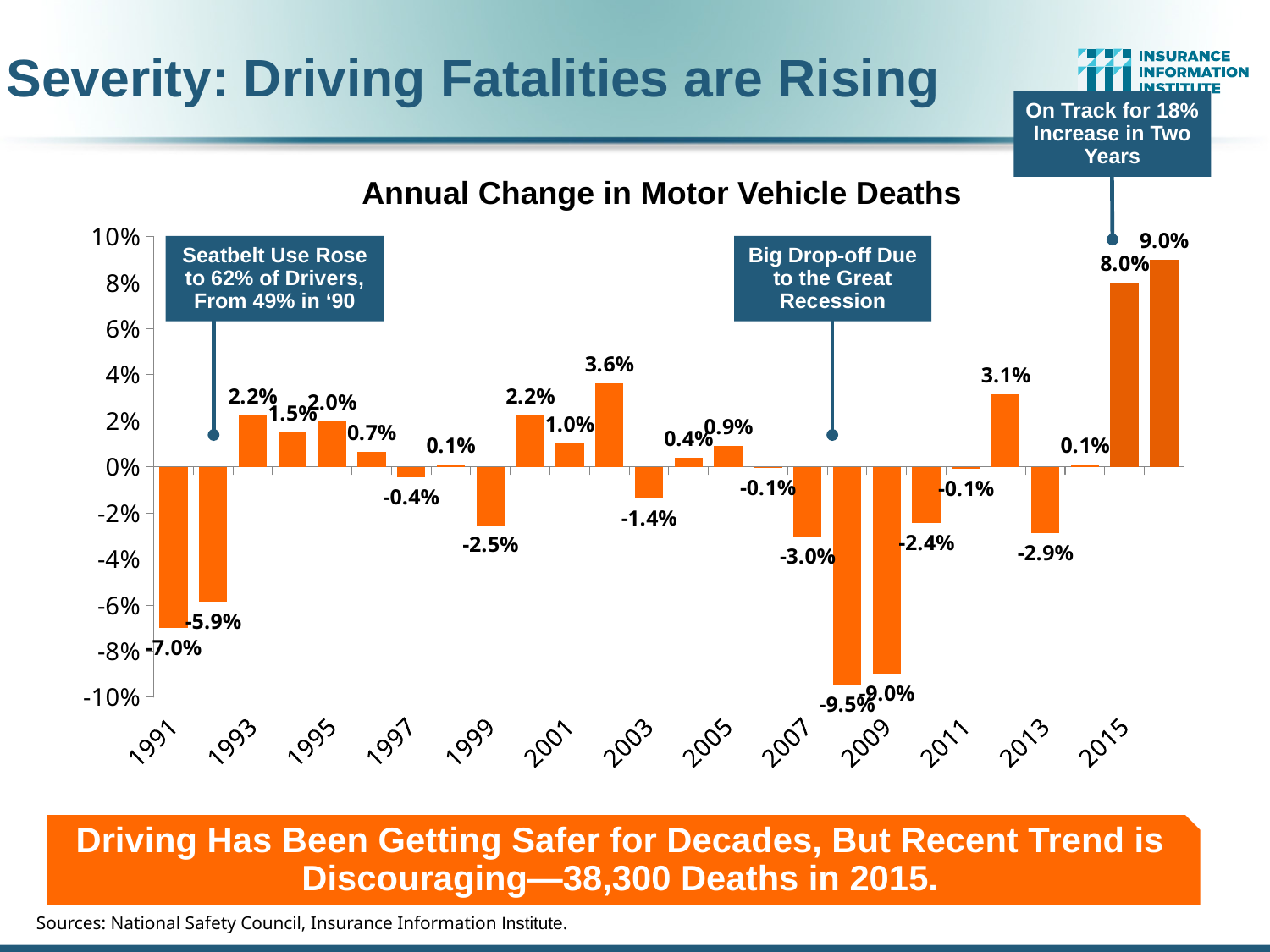
What is the lowest value shown on the chart? -9.5% What kind of chart is shown on the slide? bar chart What is the annual change in motor vehicle deaths for 2009? -9.0% Which year has the larger annual change, 2007 or 2011? 2011 What is the annual change in motor vehicle deaths for 2013? -2.9% What is the annual change in motor vehicle deaths for 2015? 8.0% What is the difference between the values for 2015 and 2013? 10.9 percentage points What is the annual change in motor vehicle deaths for 1991? -7.0% How many bars are plotted on the chart? 26 Is the value for 2015 greater or less than 6%? greater What is the highest value shown on the chart? 9.0% What is the title of the chart? Annual Change in Motor Vehicle Deaths